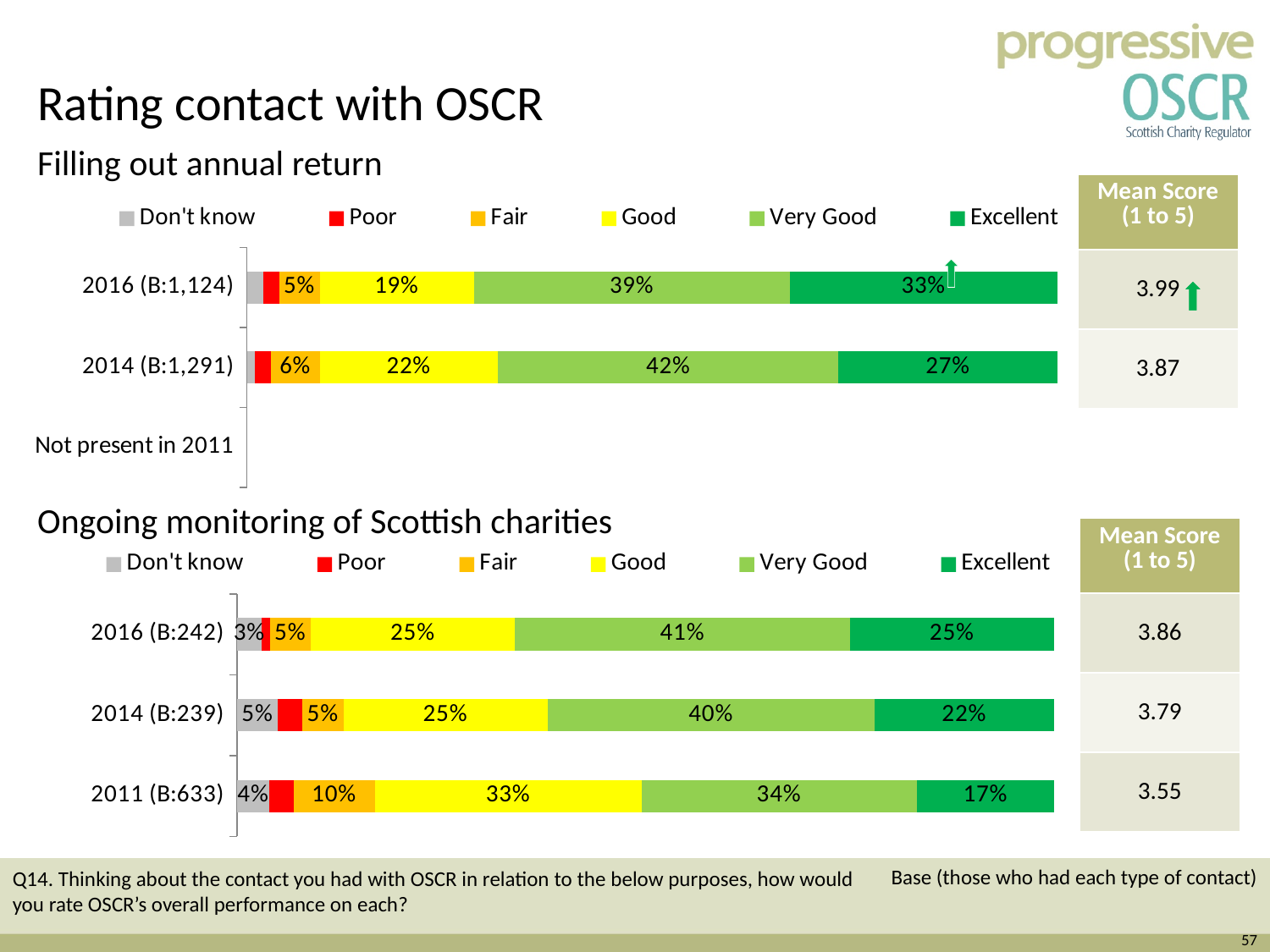
In the 'Filling out annual return' chart, which year has the larger Excellent share, 2016 or 2014? 2016 In the 'Ongoing monitoring of Scottish charities' chart, what colour represents the Excellent category? Dark green In the 'Ongoing monitoring of Scottish charities' chart, which year has the lowest Excellent share? 2011 In the 'Ongoing monitoring of Scottish charities' chart, what percentage rated it Fair in 2011? 10% How many series does the legend of the 'Filling out annual return' chart list? 6 What kind of chart is used for 'Ongoing monitoring of Scottish charities'? Stacked bar chart In the 'Ongoing monitoring of Scottish charities' chart, which year has the highest Very Good share? 2016 In the 'Ongoing monitoring of Scottish charities' chart, what is the difference between the Excellent share in 2016 and in 2011? 8% In the 'Filling out annual return' chart, what percentage rated it Very Good in 2014? 42% In the 'Filling out annual return' chart, what is the difference between the Good share in 2014 and in 2016? 3% How many years (bars) are plotted in the 'Ongoing monitoring of Scottish charities' chart? 3 In the 'Filling out annual return' chart, what percentage rated it Excellent in 2016? 33%